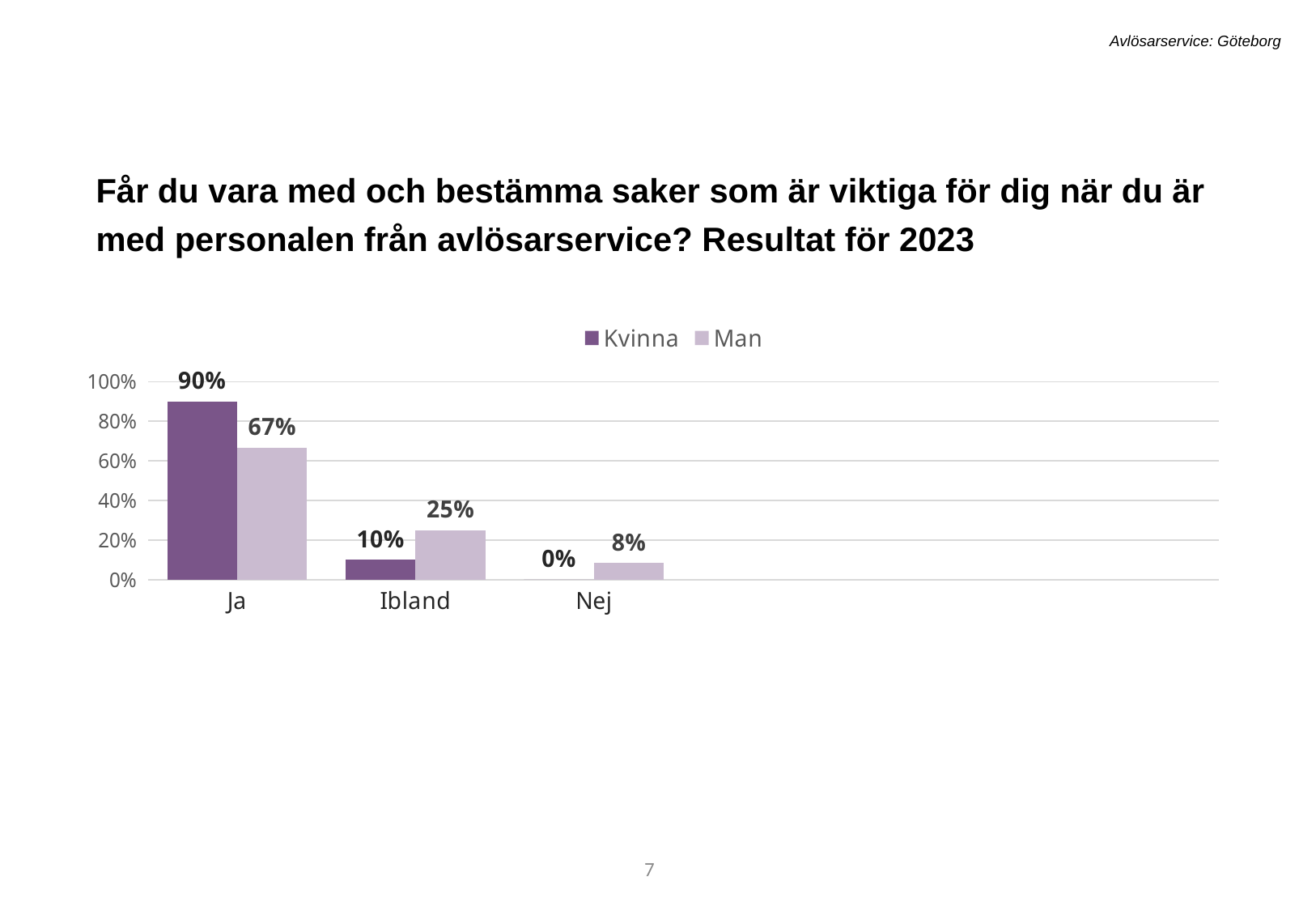
What are the two series named in the legend? Kvinna and Man What is the value for Man in the Ibland category? 25% In the Ibland category, which series has the larger value, Kvinna or Man? Man What is the value for Kvinna in the Nej category? 0% What is the difference between the Kvinna and Man values in the Ja category? 23% How many categories are shown on the x axis? 3 Which category has the highest value for Man? Ja Which category has the lowest value for Kvinna? Nej What kind of chart is shown on the slide? Bar chart How many series does the legend list? 2 What is the value for Man in the Ja category? 67% What is the value for Kvinna in the Ja category? 90%